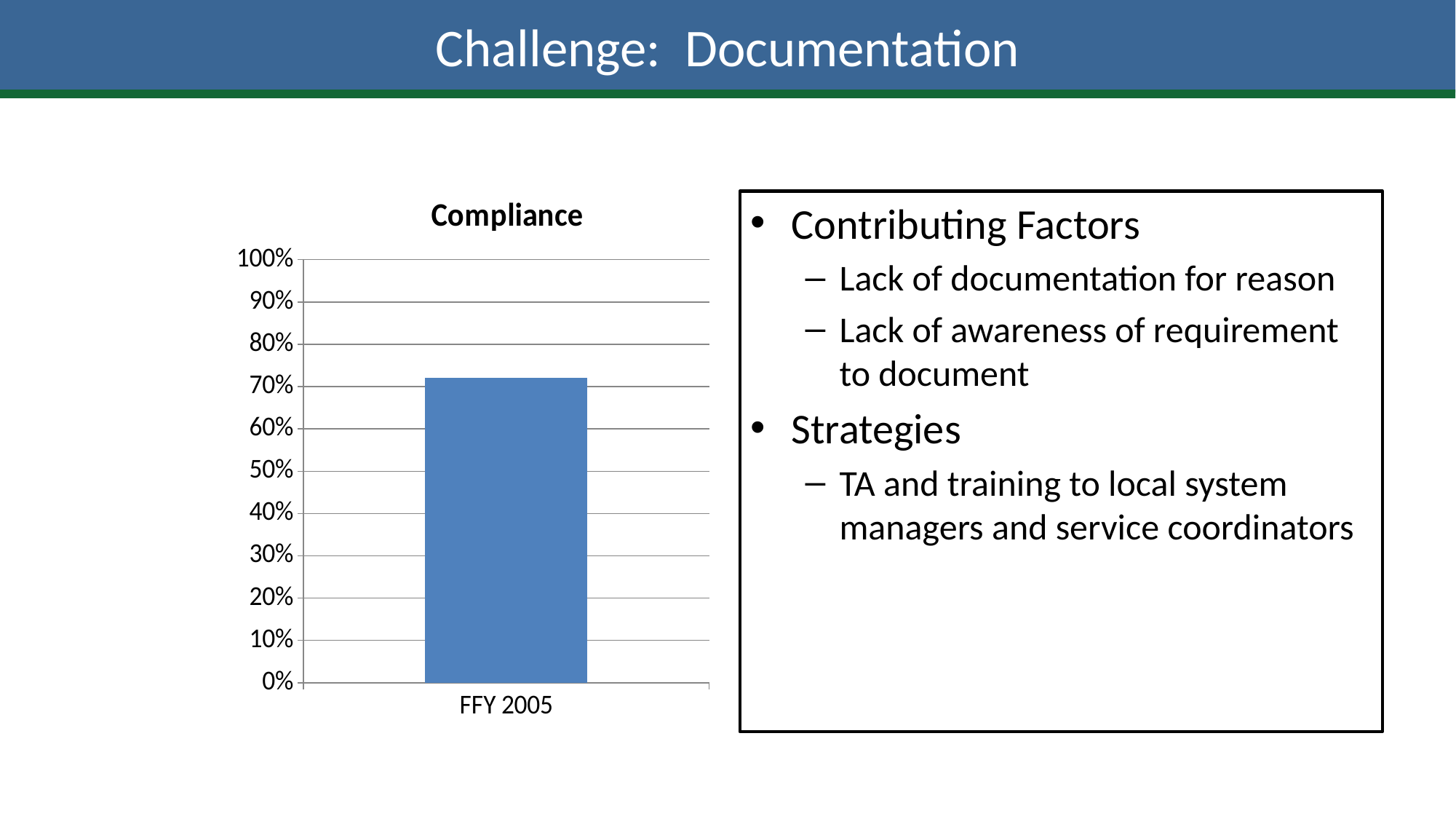
What is the category label on the x axis of the chart? FFY 2005 Is the value for FFY 2005 greater or less than 60%? greater How many bars does the chart show? 1 Is the value for FFY 2005 greater or less than 90%? less Is the value for FFY 2005 greater or less than 50%? greater What kind of chart is shown on the slide? bar chart What is the title of the chart? Compliance